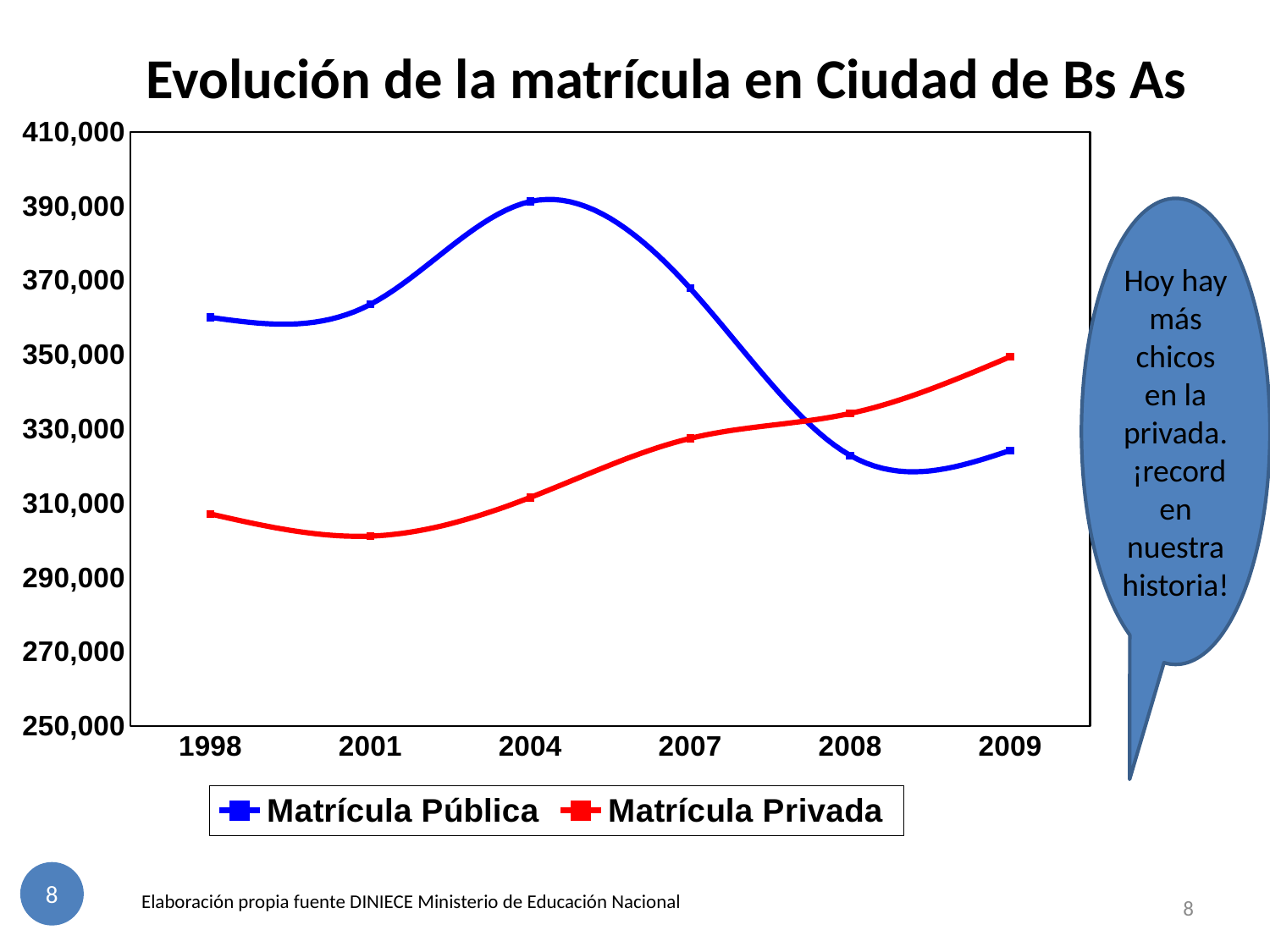
Is the value for Matrícula Pública in 2008 greater or less than 330,000? less Does Matrícula Privada rise or fall from 2001 to 2009? rise In which year does Matrícula Pública reach its highest value? 2004 In 2009, which series has the larger value, Matrícula Pública or Matrícula Privada? Matrícula Privada Is the value for Matrícula Privada in 2001 greater or less than 310,000? less What kind of chart is shown on the slide? line chart In which year does Matrícula Privada reach its highest value? 2009 In which year is Matrícula Privada at its lowest? 2001 How many series does the legend list? 2 What colour is the Matrícula Privada line? red Is the value for Matrícula Pública in 2004 greater or less than 370,000? greater How many years are shown on the x axis? 6